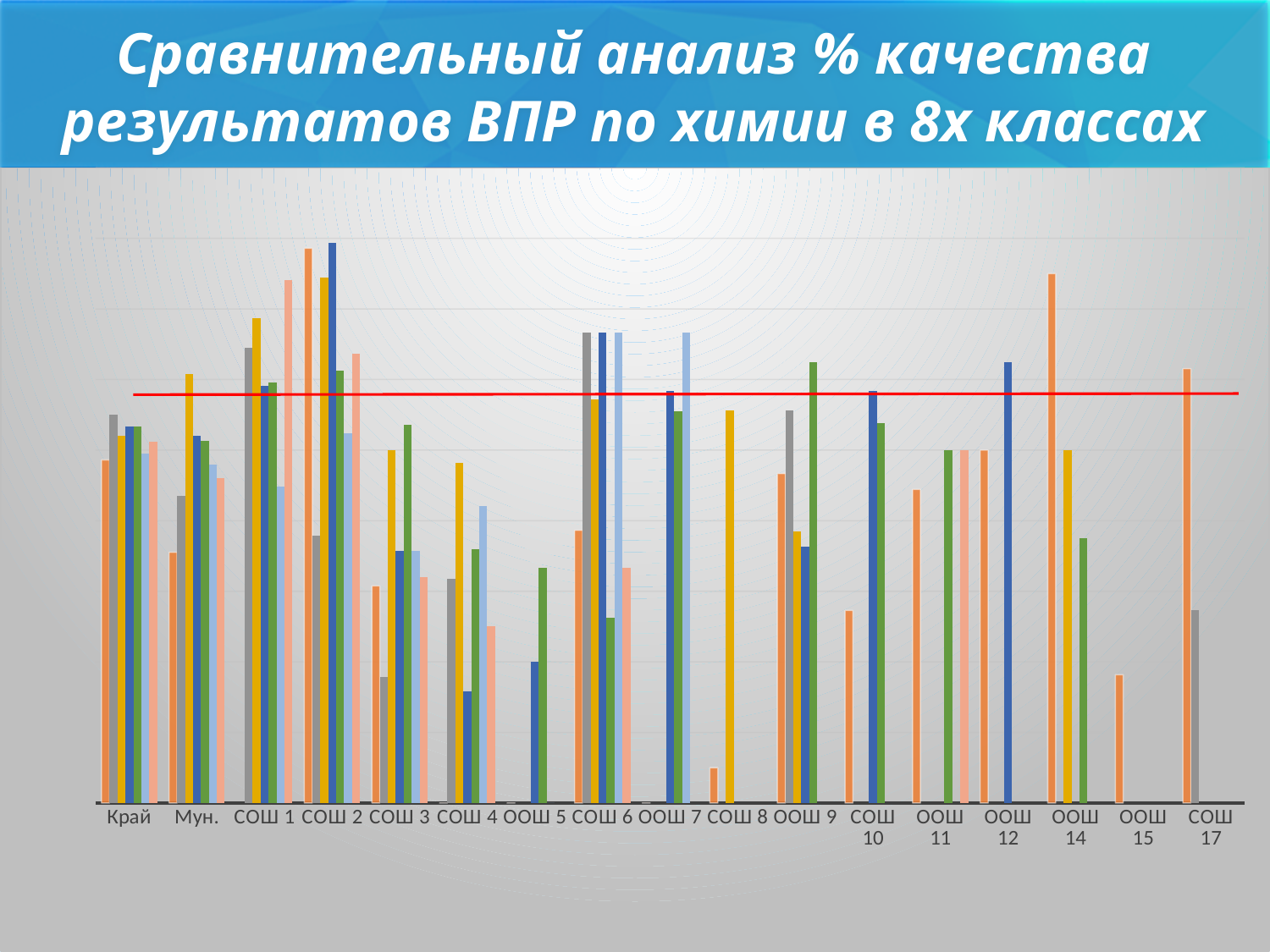
What is the title of the slide containing the chart? Сравнительный анализ % качества результатов ВПР по химии в 8х классах What is the first category labelled on the x axis? Край Which category has the taller dark blue bar, ООШ 12 or СОШ 4? ООШ 12 How many categories are labelled along the x axis of the chart? 17 Which category contains the tallest bar in the chart? СОШ 2 Which category has the taller green bar, ООШ 9 or СОШ 6? ООШ 9 Which category has the taller orange bar, СОШ 17 or СОШ 10? СОШ 17 What kind of chart is shown on the slide? bar chart